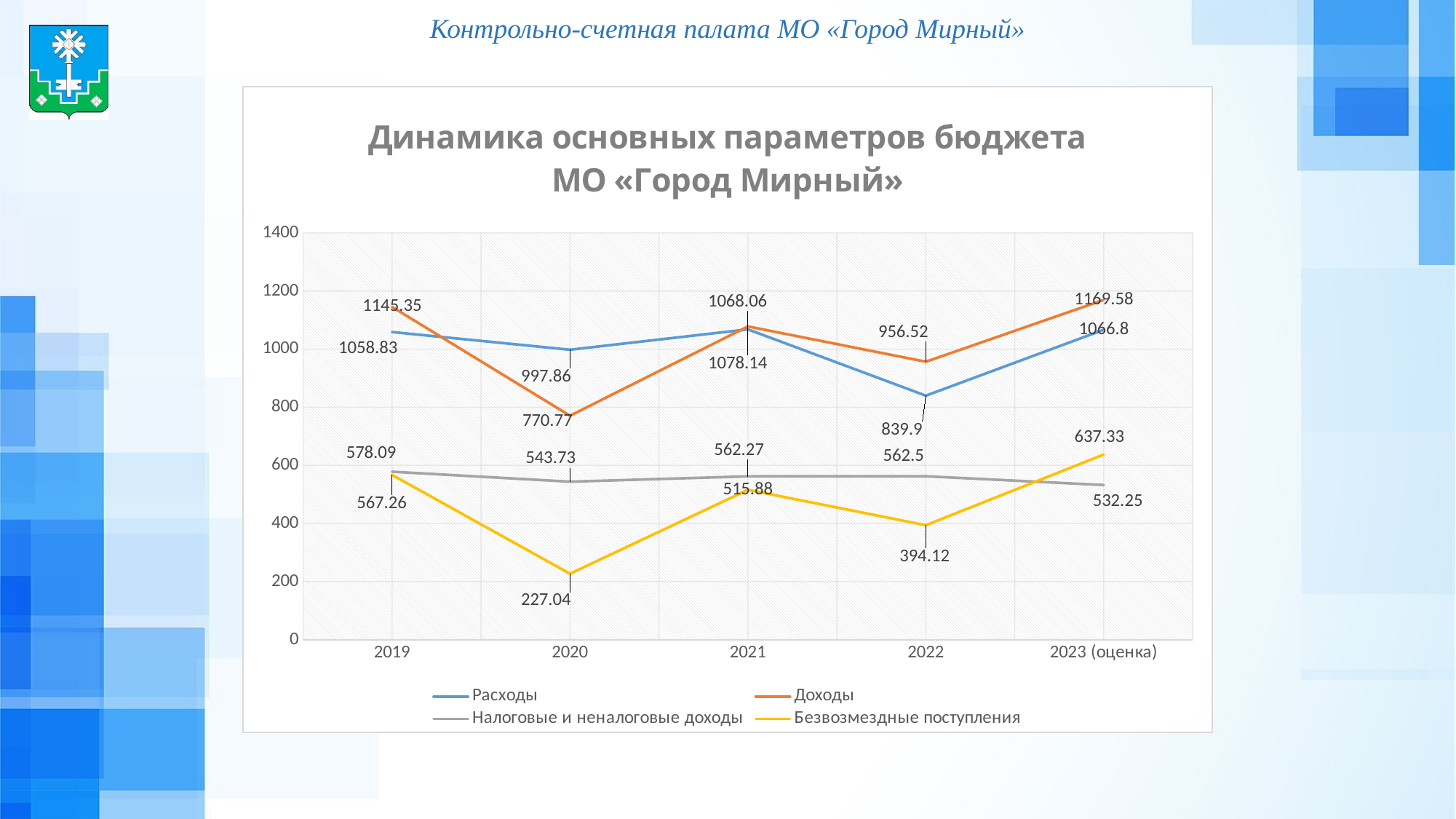
What type of chart is shown on the slide? line chart What is the value of Расходы in 2022? 839.9 How many series does the legend list? 4 In which year is Доходы highest? 2023 (оценка) What is the difference between Расходы and Доходы in 2020? 227.09 How many years (categories) are shown on the x axis? 5 What is the value of Налоговые и неналоговые доходы in 2023 (оценка)? 532.25 What is the value of Безвозмездные поступления in 2020? 227.04 Which is larger in 2022, Доходы or Расходы? Доходы What is the value of Доходы in 2019? 1145.35 In which year is Безвозмездные поступления lowest? 2020 Does Безвозмездные поступления rise or fall from 2022 to 2023 (оценка)? rise